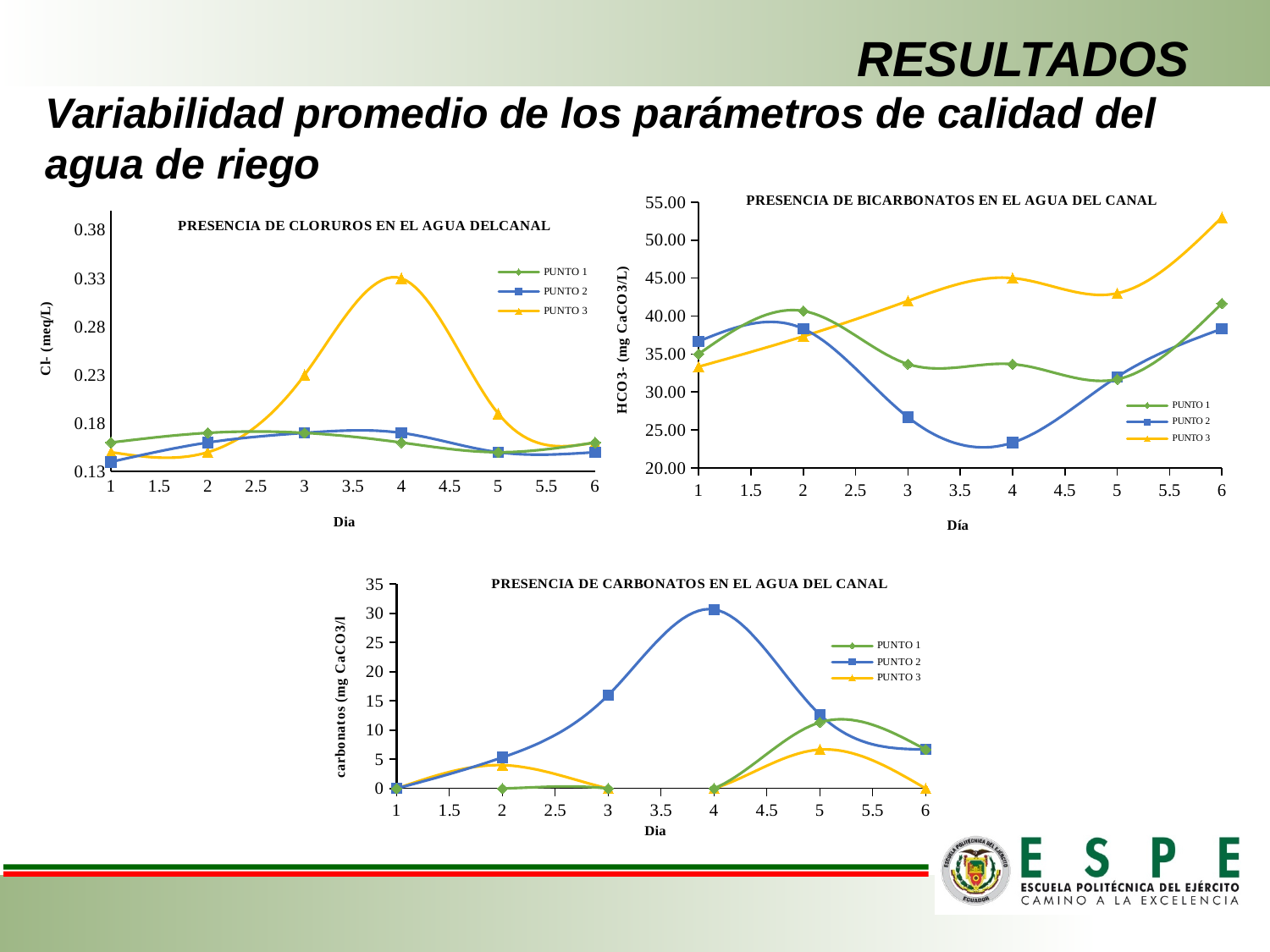
In the 'PRESENCIA DE CLORUROS EN EL AGUA DELCANAL' chart, is the value for PUNTO 3 on day 4 greater or less than 0.28? greater In the 'PRESENCIA DE CLORUROS EN EL AGUA DELCANAL' chart, on which day does PUNTO 3 reach its highest value? 4 In the 'PRESENCIA DE BICARBONATOS EN EL AGUA DEL CANAL' chart, which series has the highest value on day 6? PUNTO 3 What is the x-axis label of the 'PRESENCIA DE BICARBONATOS EN EL AGUA DEL CANAL' chart? Día In the 'PRESENCIA DE BICARBONATOS EN EL AGUA DEL CANAL' chart, is the value for PUNTO 3 on day 6 greater or less than 50.00? greater How many series does the legend of the 'PRESENCIA DE BICARBONATOS EN EL AGUA DEL CANAL' chart list? 3 In the 'PRESENCIA DE CARBONATOS EN EL AGUA DEL CANAL' chart, is the value for PUNTO 2 on day 4 greater or less than 25? greater In the 'PRESENCIA DE CARBONATOS EN EL AGUA DEL CANAL' chart, which series is higher on day 3, PUNTO 2 or PUNTO 3? PUNTO 2 How many days are plotted along the x axis of the 'PRESENCIA DE CARBONATOS EN EL AGUA DEL CANAL' chart? 6 What kind of chart is the 'PRESENCIA DE CLORUROS EN EL AGUA DELCANAL' chart? line chart In the 'PRESENCIA DE CARBONATOS EN EL AGUA DEL CANAL' chart, what is the value for PUNTO 1 on day 3? 0